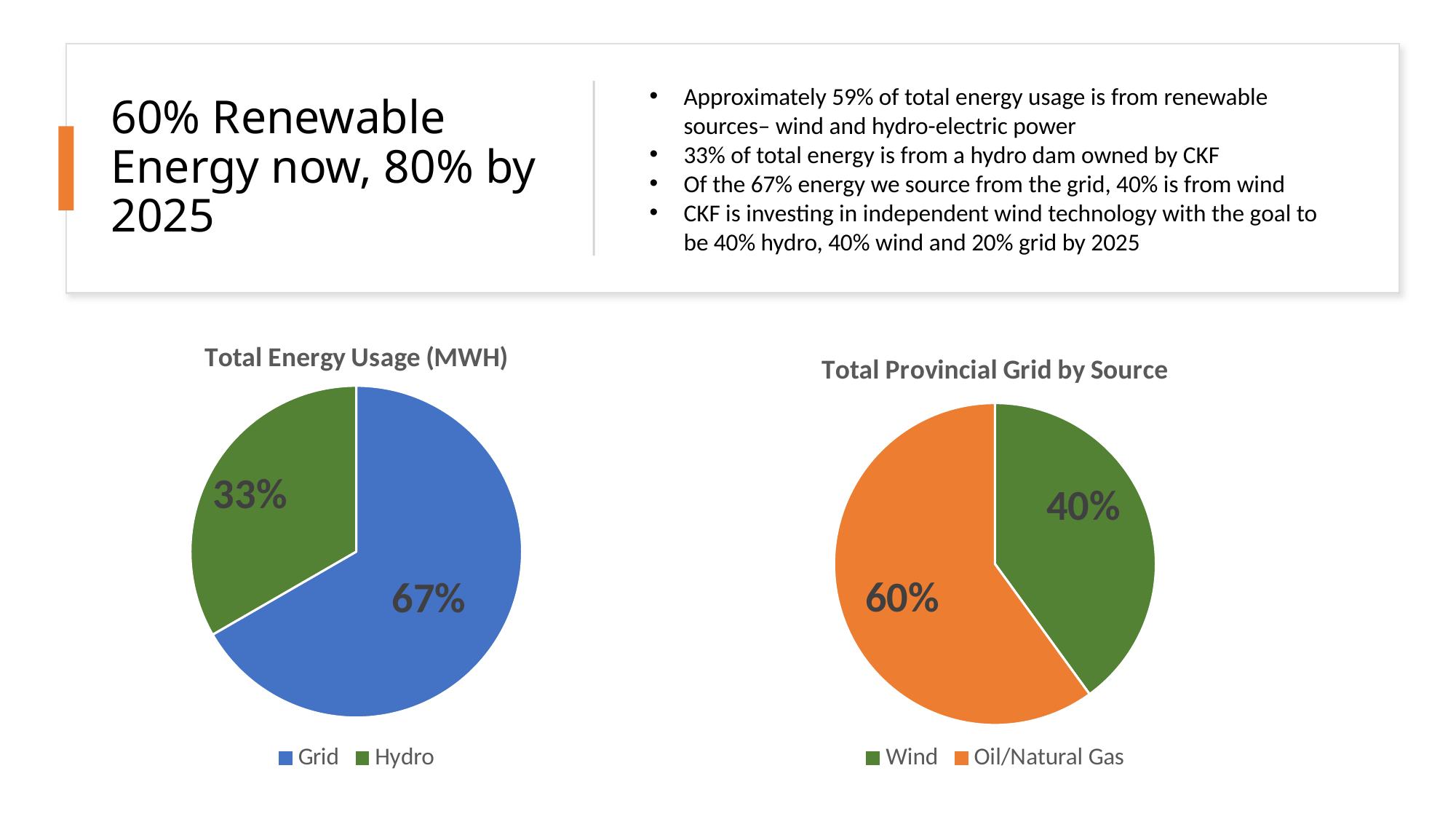
What kind of chart is the 'Total Energy Usage (MWH)' chart? Pie chart In the 'Total Energy Usage (MWH)' chart, what is the difference between the Grid and Hydro shares? 34% In the 'Total Energy Usage (MWH)' chart, what share of the pie is Hydro? 33% What is the title of the chart on the right side of the slide? Total Provincial Grid by Source In the 'Total Provincial Grid by Source' chart, which category has the smallest slice? Wind In the 'Total Provincial Grid by Source' chart, what share of the pie is Wind? 40% In the 'Total Provincial Grid by Source' chart, what share of the pie is Oil/Natural Gas? 60% In the 'Total Provincial Grid by Source' chart, which is larger, Wind or Oil/Natural Gas? Oil/Natural Gas How many categories does the 'Total Provincial Grid by Source' chart show? 2 In the 'Total Energy Usage (MWH)' chart, what colour is the Hydro slice? Green In the 'Total Energy Usage (MWH)' chart, which category has the largest slice? Grid